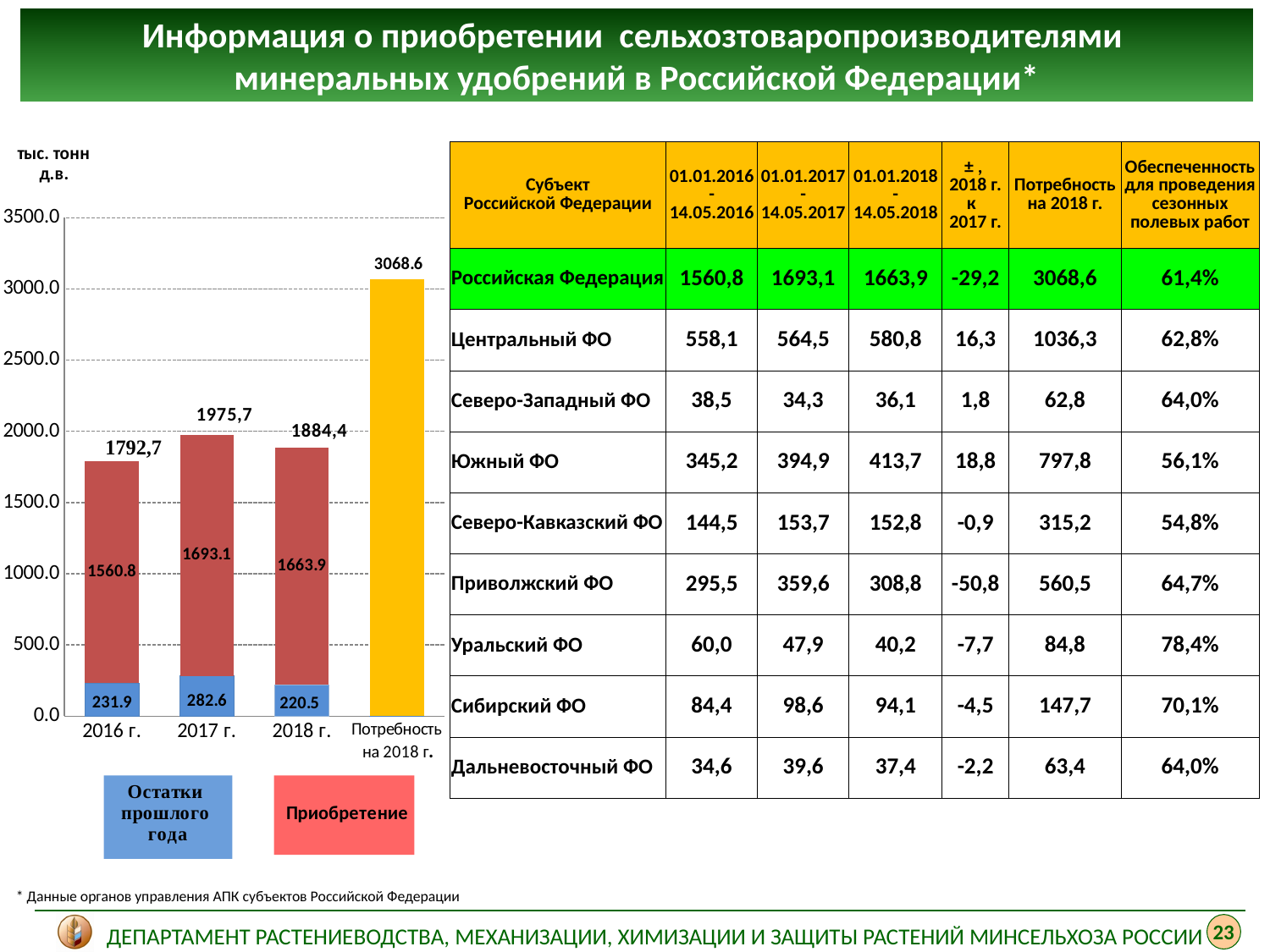
Which year has the lowest Приобретение value? 2016 г. Which is larger, the Остатки прошлого года value for 2016 г. or for 2018 г.? 2016 г. What kind of chart is shown on the slide? stacked bar chart How many series does the legend list? 2 What is the value of the Остатки прошлого года segment for 2018 г.? 220.5 What is the value of the Приобретение segment for 2017 г.? 1693.1 How many bars are shown on the chart? 4 What is the difference between the Приобретение values for 2017 г. and 2016 г.? 132.3 What is the total of the stacked bar for 2016 г.? 1792,7 What is the value of the Потребность на 2018 г. bar? 3068.6 Which year has the highest Остатки прошлого года value? 2017 г. Is the Потребность на 2018 г. bar greater or less than 3000.0? greater